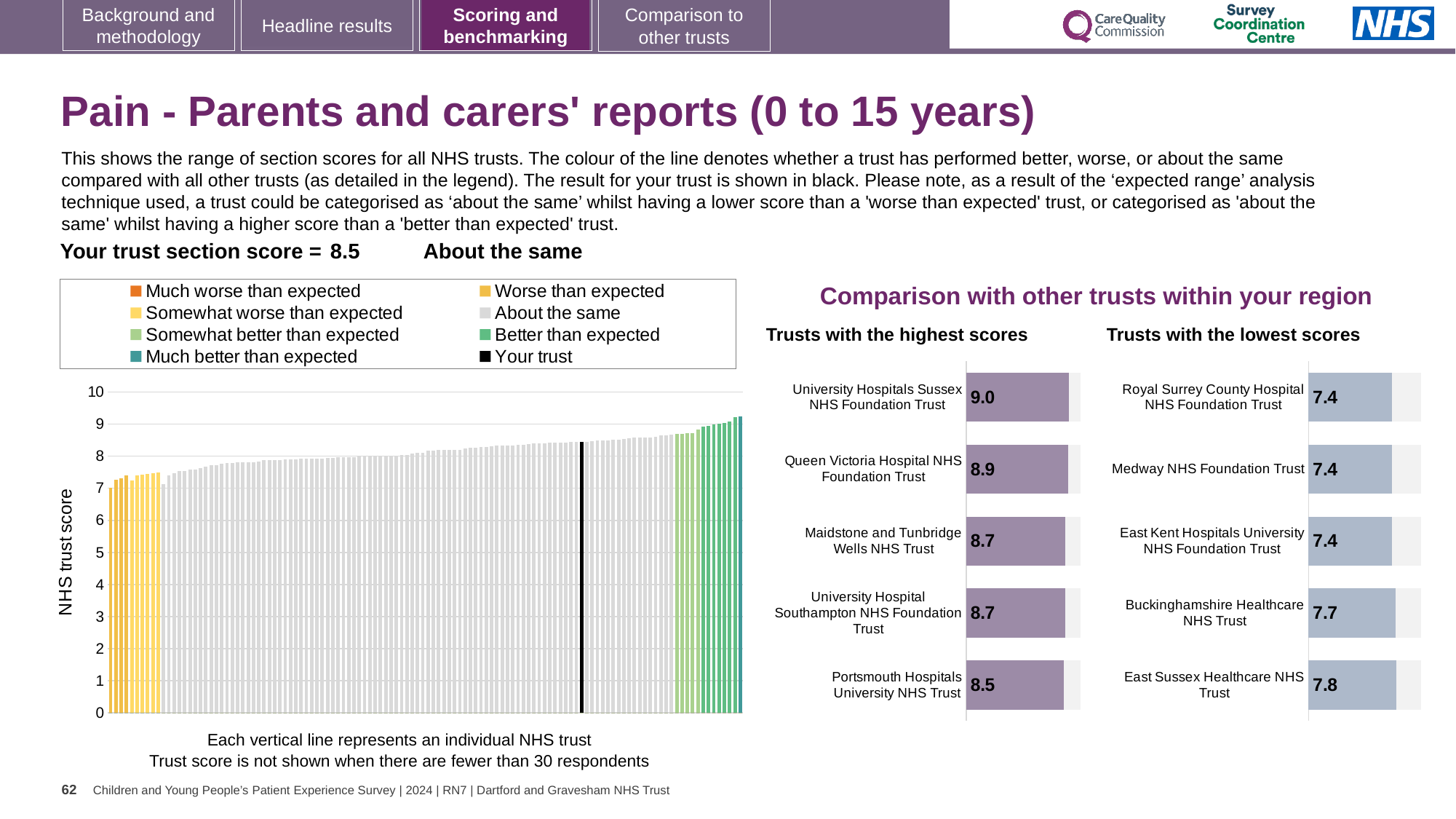
How many trusts are listed in the 'Trusts with the lowest scores' chart? 5 In the 'Trusts with the lowest scores' chart, what is the difference between the scores of East Sussex Healthcare NHS Trust and Royal Surrey County Hospital NHS Foundation Trust? 0.4 In the large chart on the left, is the value of the black bar (your trust) greater or less than 8? greater In the 'Trusts with the lowest scores' chart, what is the score for Buckinghamshire Healthcare NHS Trust? 7.7 In the 'Trusts with the highest scores' chart, which has the larger score: Queen Victoria Hospital NHS Foundation Trust or Maidstone and Tunbridge Wells NHS Trust? Queen Victoria Hospital NHS Foundation Trust How many entries does the legend of the large chart on the left list? 8 In the 'Trusts with the highest scores' chart, which trust has the highest score? University Hospitals Sussex NHS Foundation Trust What kind of chart is the large chart on the left showing NHS trust scores? Bar chart In the 'Trusts with the lowest scores' chart, which trust has the highest score? East Sussex Healthcare NHS Trust In the 'Trusts with the highest scores' chart, what is the difference between the scores of University Hospitals Sussex NHS Foundation Trust and Portsmouth Hospitals University NHS Trust? 0.5 How many trusts are listed in the 'Trusts with the highest scores' chart? 5 In the 'Trusts with the highest scores' chart, what is the score for University Hospitals Sussex NHS Foundation Trust? 9.0